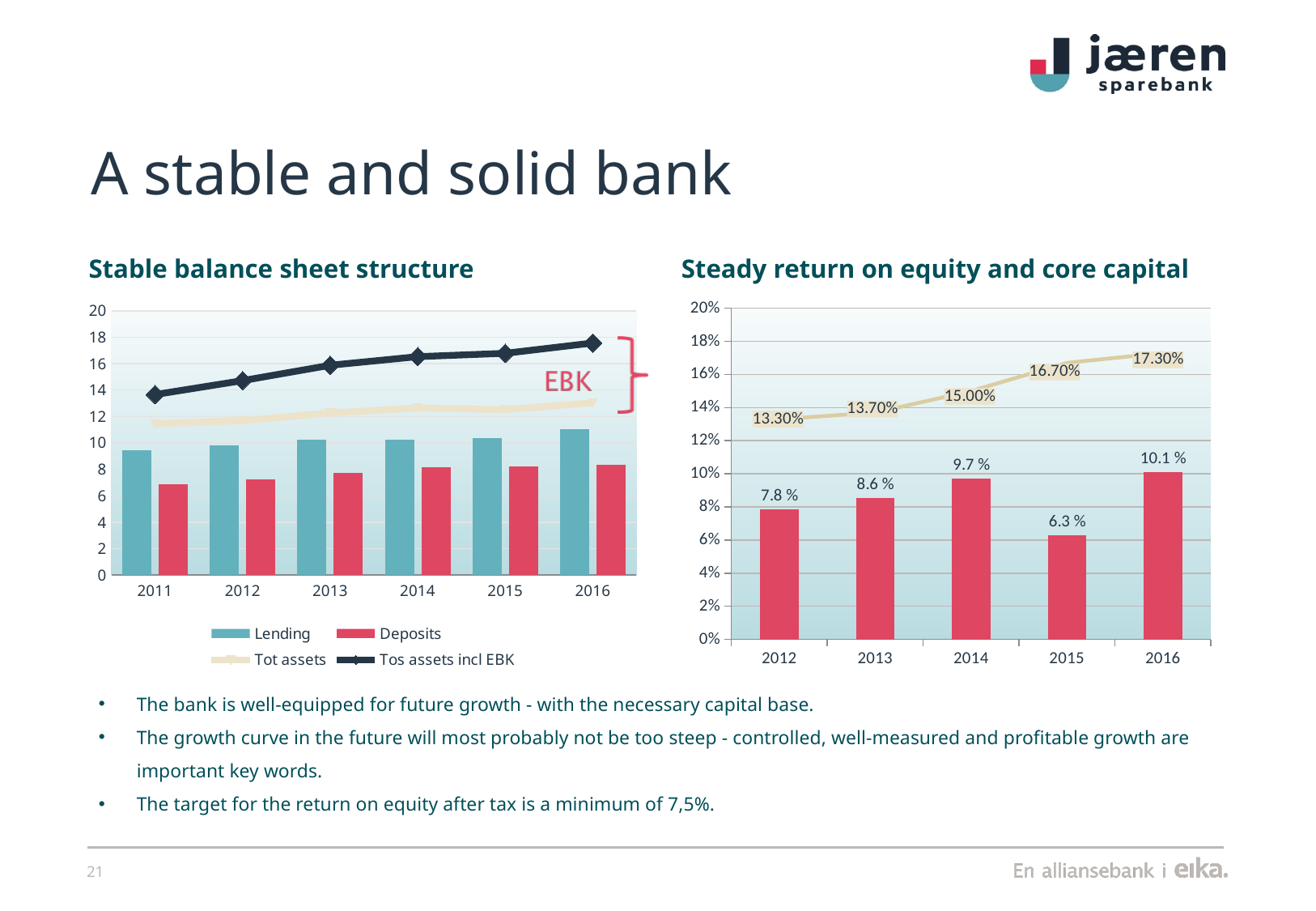
In the 'Steady return on equity and core capital' chart, which year has the lowest bar? 2015 In the 'Steady return on equity and core capital' chart, which bar is larger, 2013 or 2014? 2014 In the 'Steady return on equity and core capital' chart, what is the difference between the bar values for 2016 and 2015? 3.8 % In the 'Steady return on equity and core capital' chart, what is the value of the line for 2016? 17.30% How many series does the legend of the 'Stable balance sheet structure' chart list? 4 How many years are shown on the x axis of the 'Stable balance sheet structure' chart? 6 In the 'Steady return on equity and core capital' chart, what is the value of the bar for 2015? 6.3 % In the 'Steady return on equity and core capital' chart, which year has the highest bar? 2016 In the 'Steady return on equity and core capital' chart, does the line rise or fall from 2012 to 2016? rises In the 'Stable balance sheet structure' chart, is the Deposits value for 2011 greater or less than 8? less How many years are shown on the x axis of the 'Steady return on equity and core capital' chart? 5 In the 'Stable balance sheet structure' chart, is the Lending value for 2016 greater or less than 10? greater